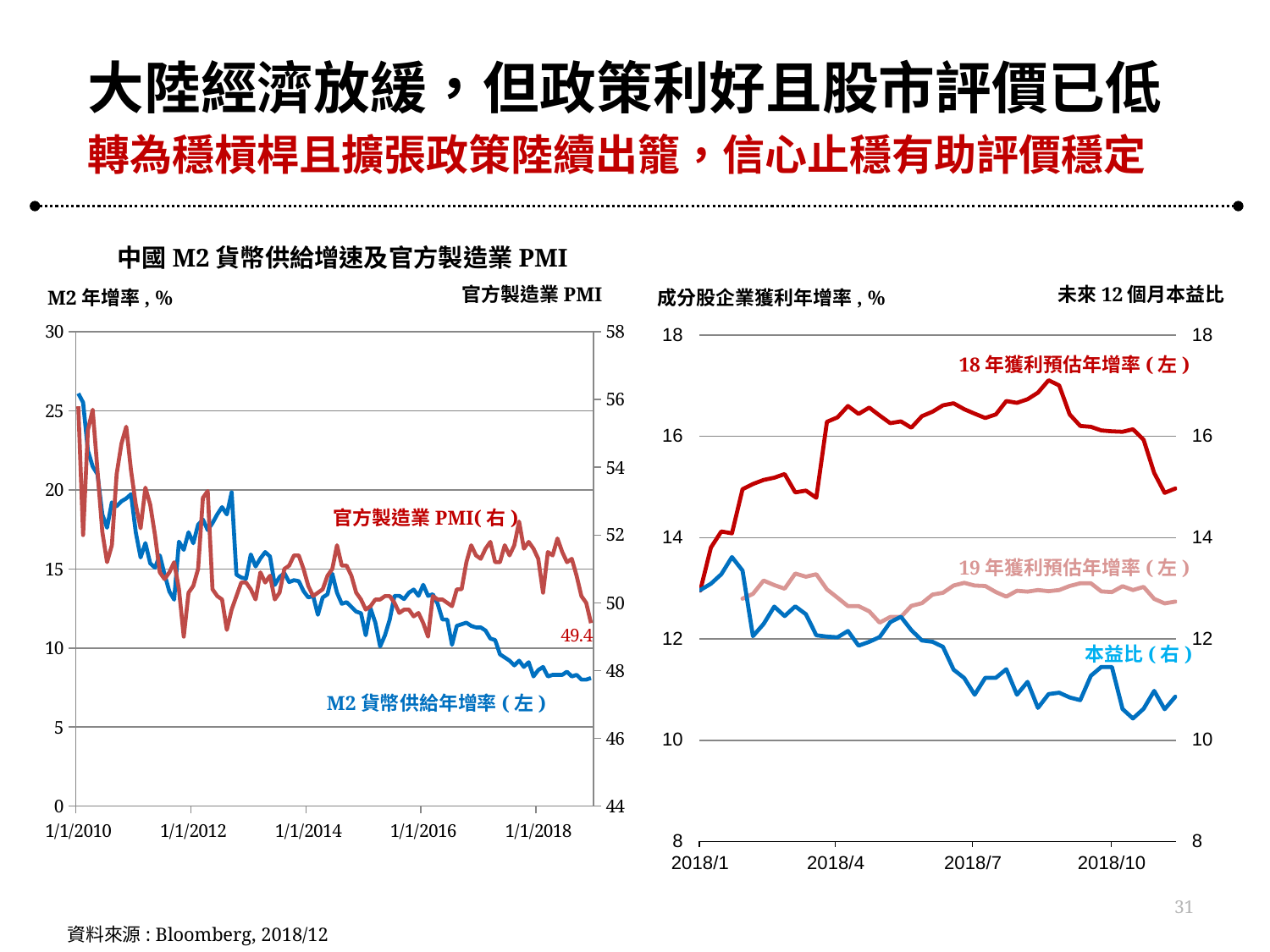
In the right chart, does the 本益比 series generally rise or fall from 2018/1 to the end of the series? fall What is the title of the left chart? 中國 M2 貨幣供給增速及官方製造業 PMI What is the label of the right-hand axis of the right chart? 未來 12 個月本益比 In the left chart, is the value of M2 貨幣供給年增率 at the end of the series (late 2018) greater or less than 10? less In the right chart, which series is higher at 2018/7: 18 年獲利預估年增率 or 19 年獲利預估年增率? 18 年獲利預估年增率 In the right chart, is the value of 18 年獲利預估年增率 at 2018/7 greater or less than 16? greater How many series are plotted in the right chart? 3 In the right chart, is the value of 本益比 at 2018/10 greater or less than 12? less In the left chart, does the M2 貨幣供給年增率 series generally rise or fall from 1/1/2010 to 2018? fall How many series are plotted in the left chart? 2 In the left chart, what is the last printed value of the 官方製造業 PMI series? 49.4 What kind of chart is the left chart titled 中國 M2 貨幣供給增速及官方製造業 PMI? line chart